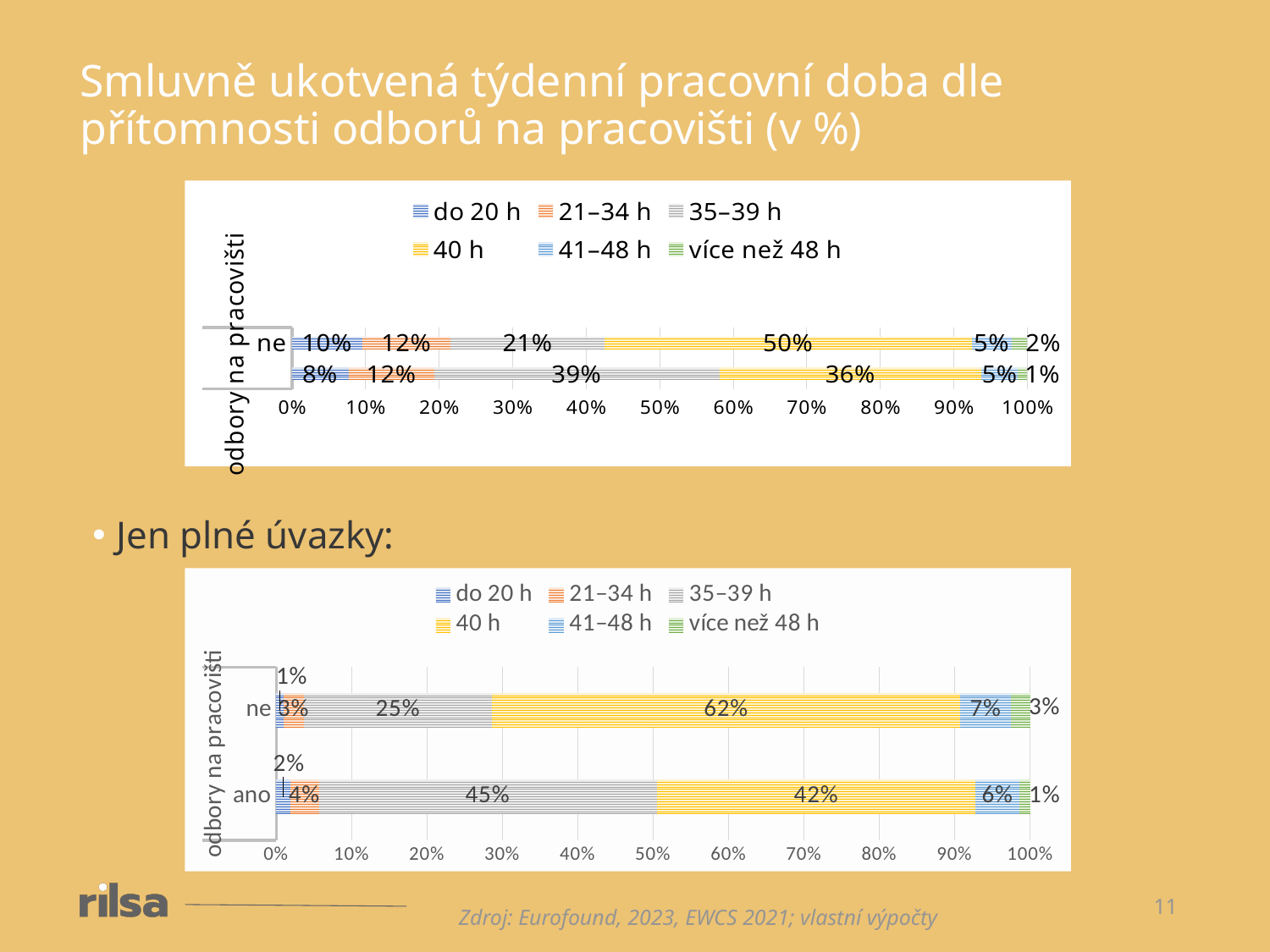
In the bottom chart (Jen plné úvazky), which is larger for 41–48 h: the 'ne' value or the 'ano' value? ne In the bottom chart (Jen plné úvazky), what is the value for 35–39 h in the 'ano' category? 45% In the bottom chart (Jen plné úvazky), what is the value for 40 h in the 'ne' category? 62% What kind of chart is the bottom chart (Jen plné úvazky)? Stacked bar chart How many categories are shown on the vertical axis of the bottom chart (Jen plné úvazky)? 2 In the bottom chart (Jen plné úvazky), what is the difference between the 40 h values for 'ne' and 'ano'? 20% How many series does the legend of the bottom chart (Jen plné úvazky) list? 6 In the top chart, what is the value for 35–39 h in the 'ne' category? 21% In the top chart, which series has the highest value in the 'ne' category? 40 h In the top chart, what is the difference between the 40 h and 35–39 h values in the 'ne' category? 29% In the bottom chart (Jen plné úvazky), which series has the highest value in the 'ano' category? 35–39 h In the top chart, what is the value for 40 h in the 'ne' category? 50%